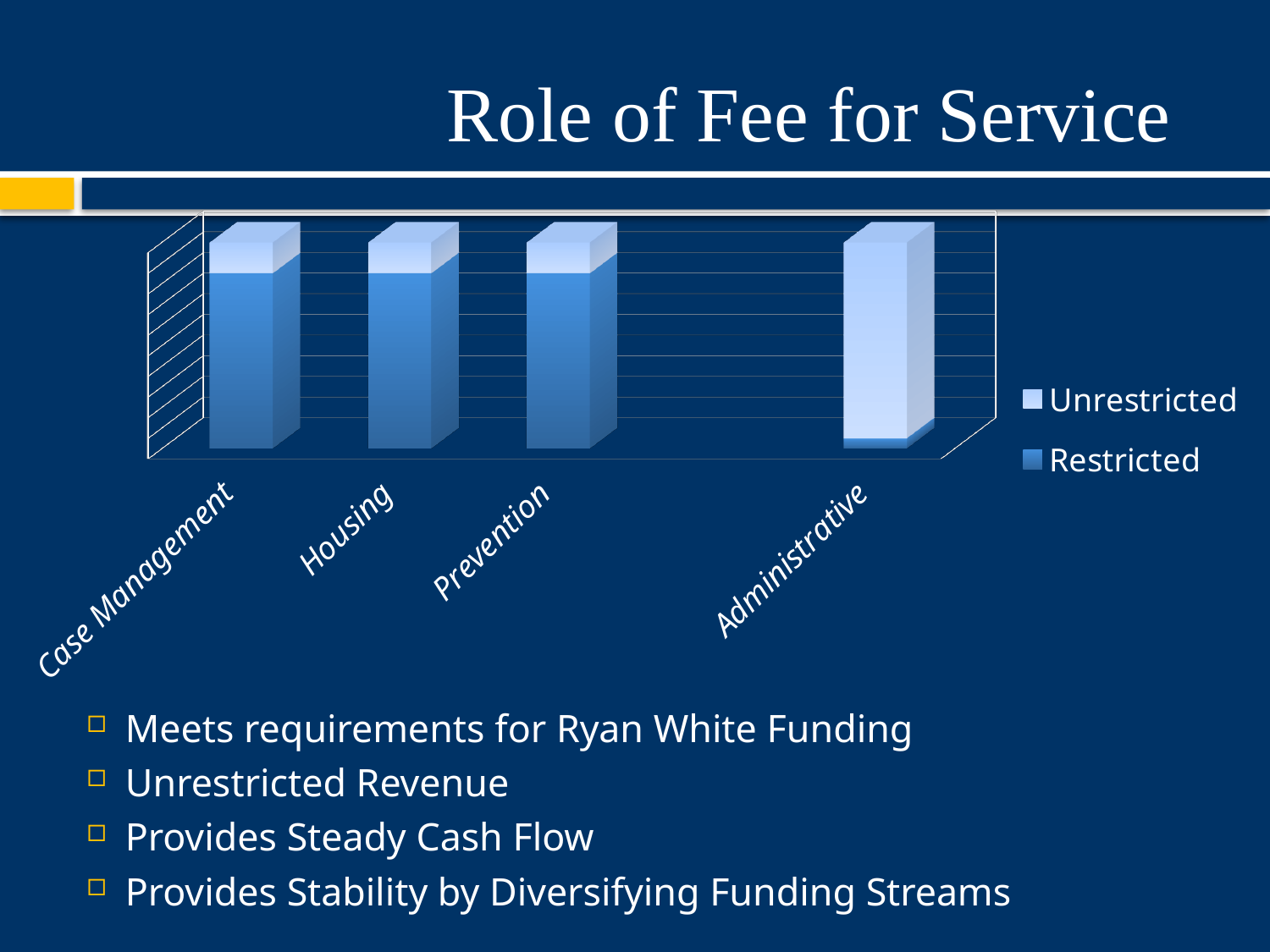
For the Housing category, which is larger: the Restricted portion or the Unrestricted portion? Restricted What are the two series named in the chart's legend? Unrestricted and Restricted For the Case Management category, which is larger: the Restricted portion or the Unrestricted portion? Restricted Which category is shown first (leftmost) on the chart's x axis? Case Management How many series does the chart's legend list? 2 Which category's Restricted portion is larger: Prevention or Administrative? Prevention Which category has the smallest Restricted portion in the chart? Administrative Which category has the largest Unrestricted portion in the chart? Administrative What kind of chart is shown on the slide? Stacked bar chart How many categories are shown on the x axis of the chart? 4